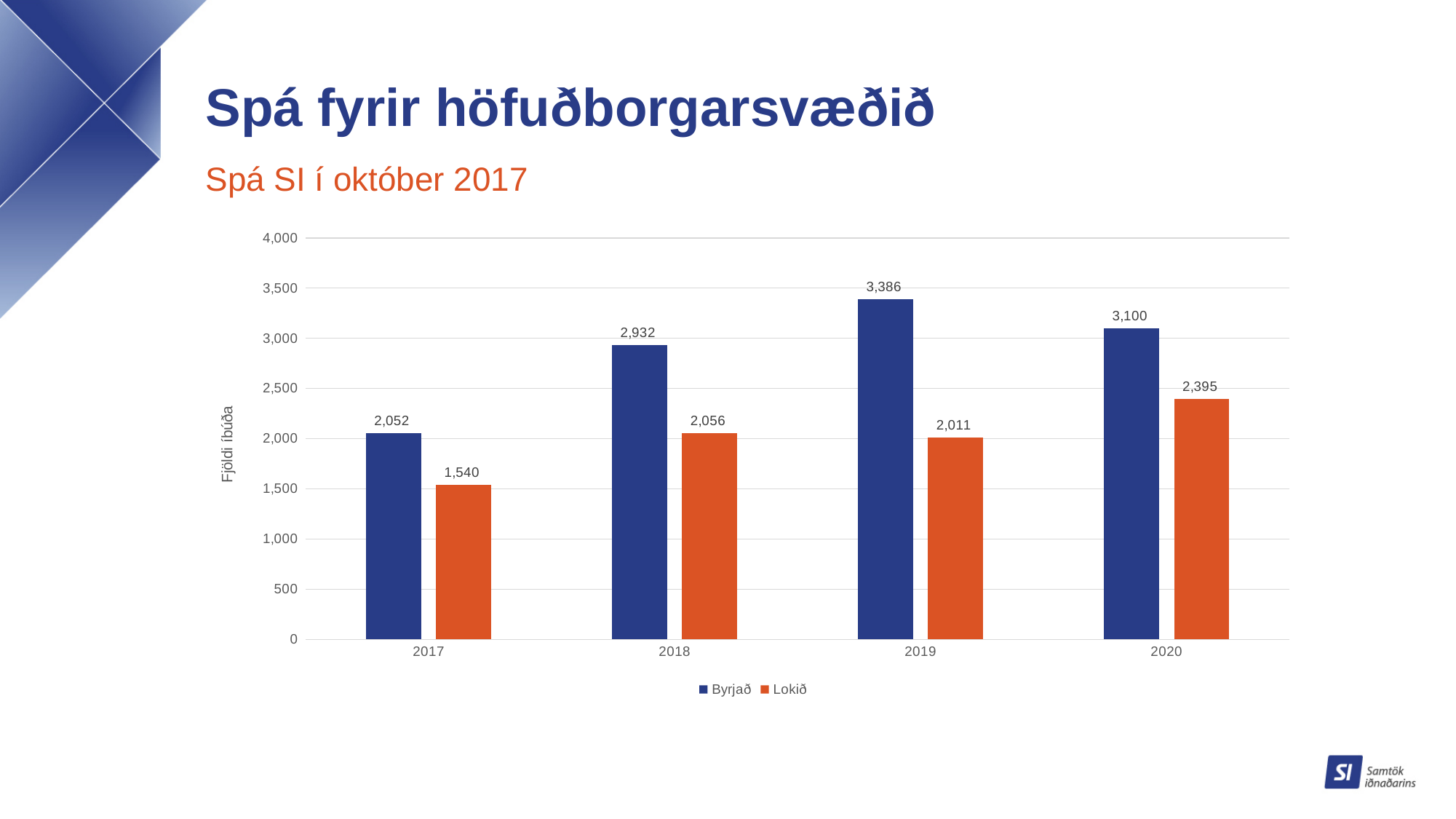
Which year has the highest Byrjað value? 2019 Is the value for Byrjað in 2018 greater or less than 2,500? greater What kind of chart is shown on the slide? Bar chart What is the difference between Byrjað and Lokið in 2018? 876 How many series does the legend list? 2 How many years are shown on the x axis? 4 What is the label on the vertical axis? Fjöldi íbúða What is the value for Lokið in 2020? 2,395 What is the value for Byrjað in 2019? 3,386 What is the value for Lokið in 2017? 1,540 Which year has the lowest Lokið value? 2017 Which is larger in 2020, Byrjað or Lokið? Byrjað